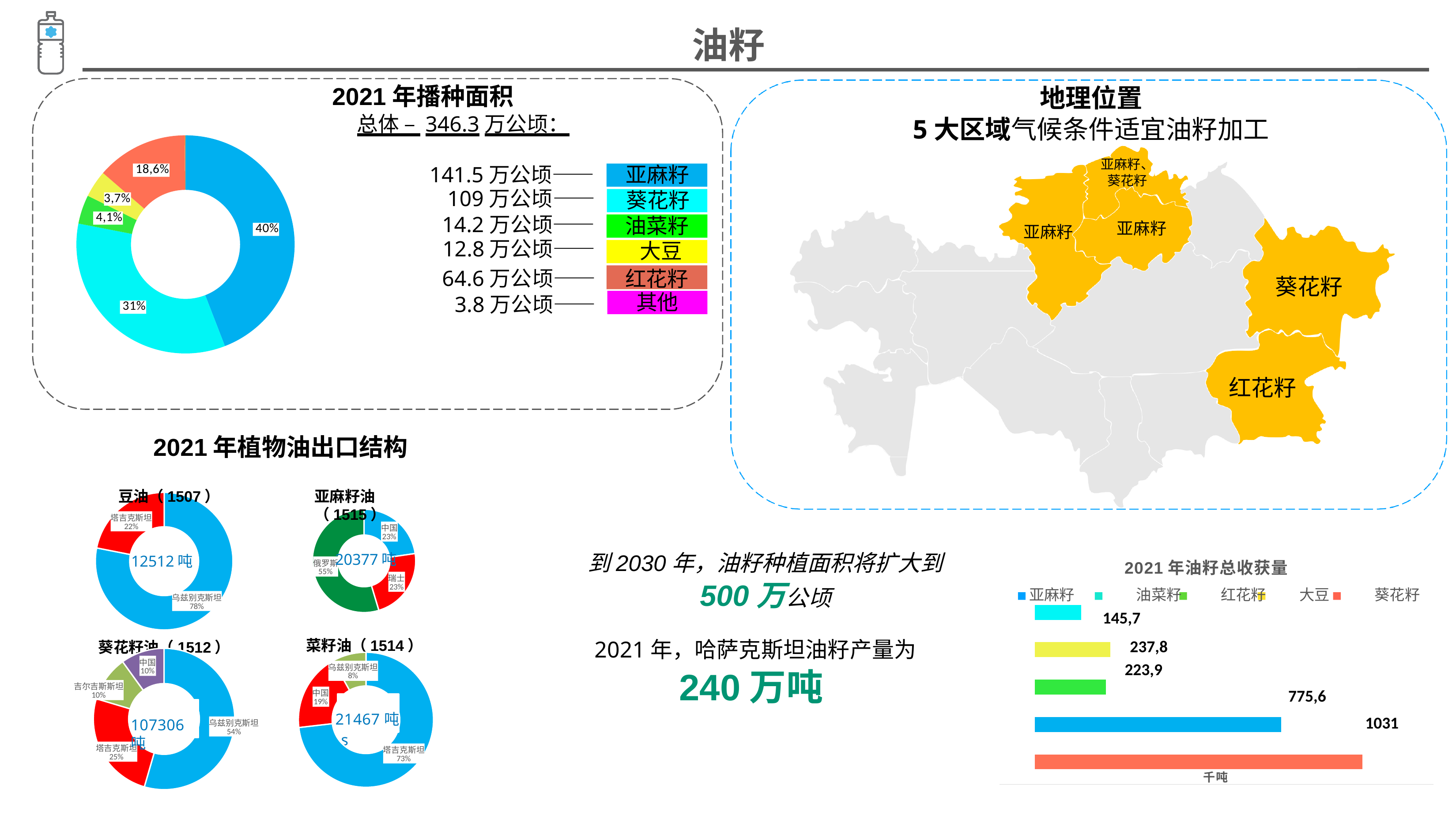
In the 2021 年播种面积 chart, what is the sown area for 葵花籽? 109 万公顷 In the 2021 年播种面积 chart, what share does 亚麻籽 have? 40% How many categories does the legend of the 2021 年播种面积 chart list? 6 In the 2021 年播种面积 chart, how much larger is the 亚麻籽 area than the 葵花籽 area? 32.5 万公顷 In the 2021 年播种面积 chart, which category has the largest area? 亚麻籽 What kind of chart is the 2021 年播种面积 chart? pie (donut) chart In the 豆油 (1507) export chart, what share goes to 乌兹别克斯坦? 78% In the 菜籽油 (1514) export chart, what share goes to 塔吉克斯坦? 73% In the 2021 年油籽总收获量 bar chart, what is the highest value shown? 1031 In the 2021 年油籽总收获量 bar chart, what is the lowest value shown? 145,7 In the 2021 年油籽总收获量 bar chart, what value is labelled on the blue bar? 775,6